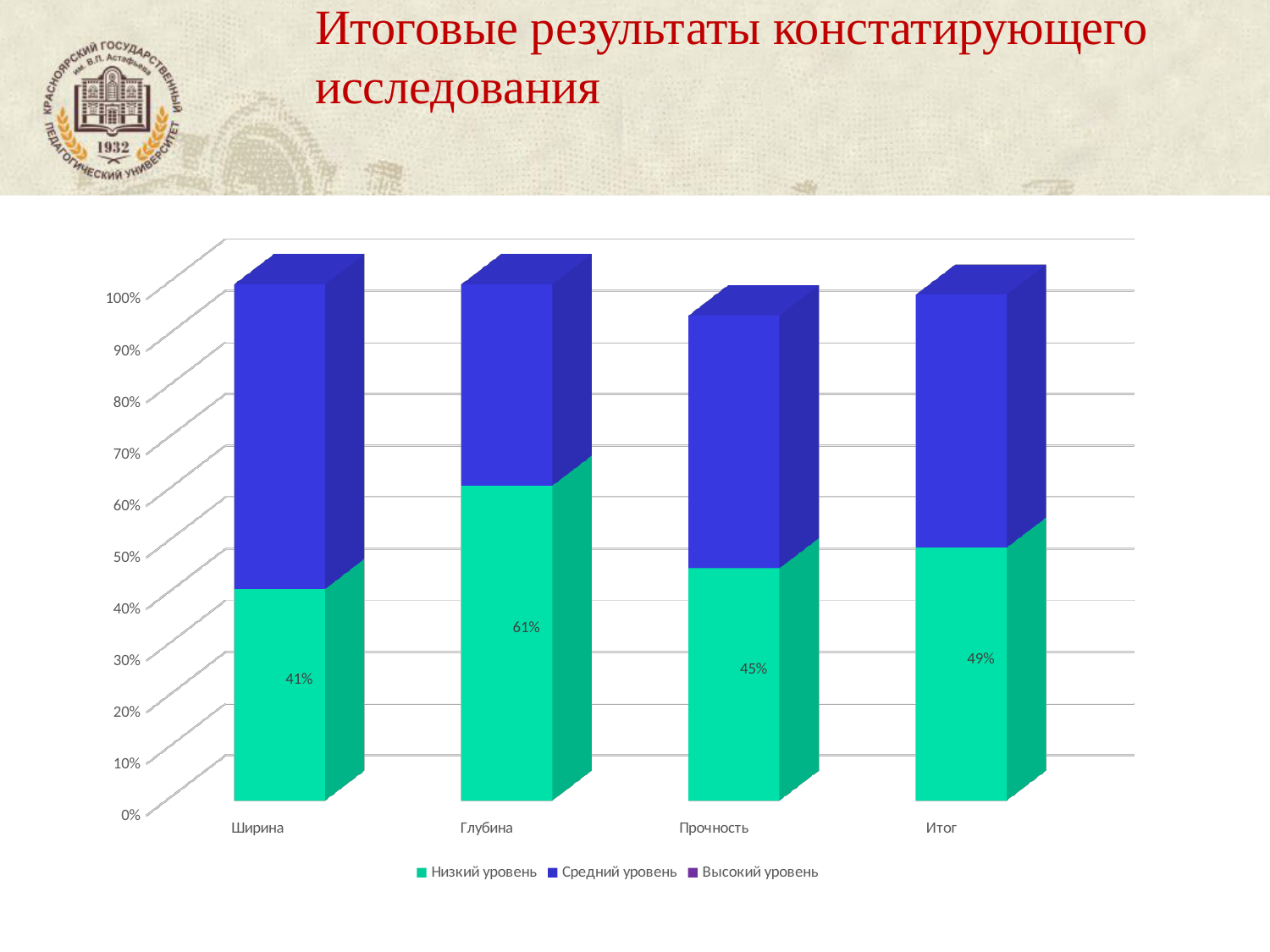
Which category has the lowest value for Низкий уровень? Ширина Which has a larger Низкий уровень value, Прочность or Итог? Итог Which category has the highest value for Низкий уровень? Глубина What is the value of Низкий уровень for Итог? 49% What is the difference between the Низкий уровень values for Глубина and Ширина? 20% What is the value of Низкий уровень for Глубина? 61% How many series does the legend list? 3 Is the Средний уровень value for Ширина greater or less than 50%? greater What kind of chart is shown on the slide? Stacked bar chart How many categories are shown on the x axis? 4 What is the value of Низкий уровень for Ширина? 41% What is the value of Низкий уровень for Прочность? 45%